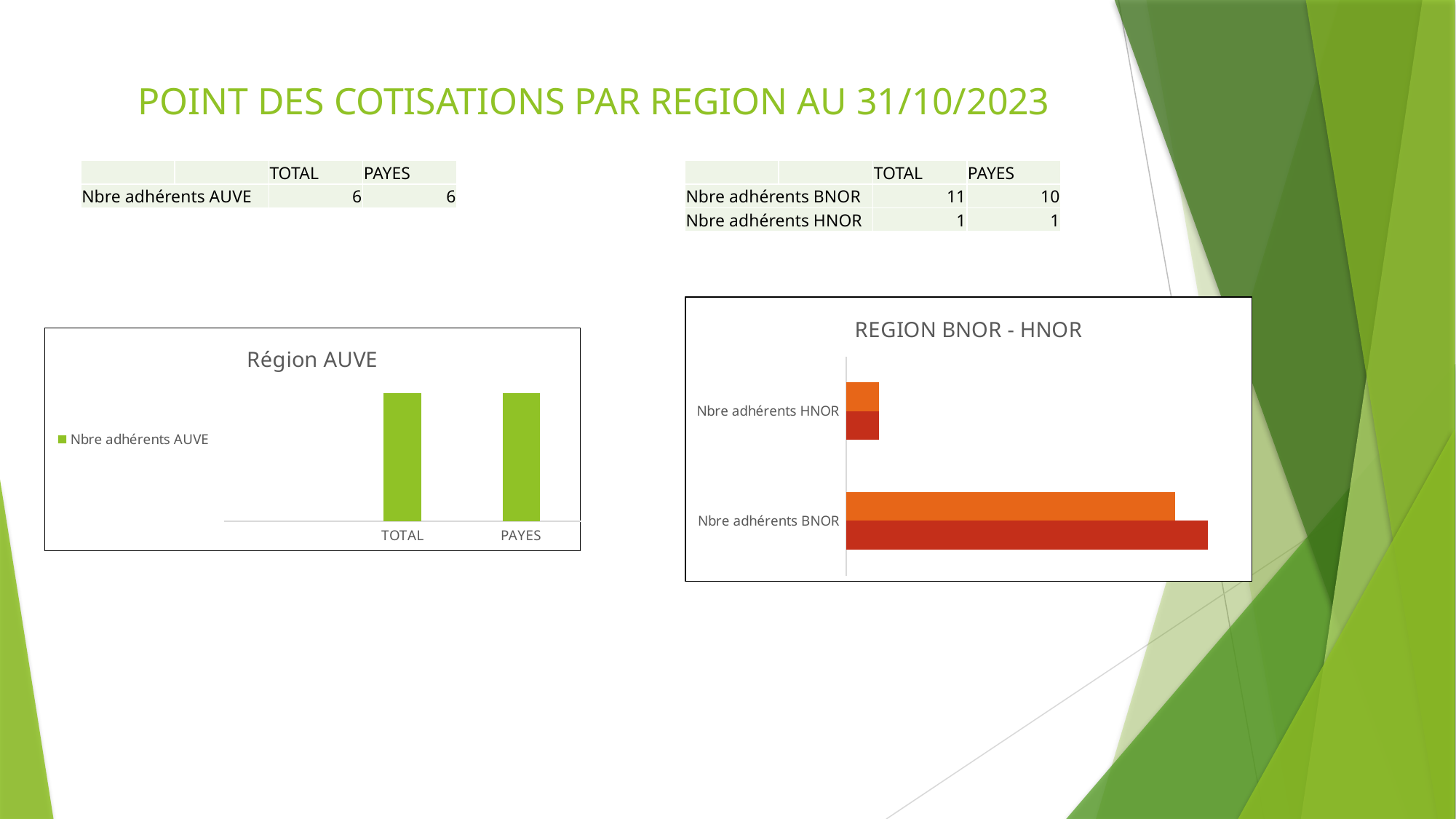
In the "Région AUVE" chart, how many categories are shown on the x axis? 2 In the "REGION BNOR - HNOR" chart, which category has the longest bars? Nbre adhérents BNOR What kind of chart is the "Région AUVE" chart? bar chart In the "REGION BNOR - HNOR" chart, how many categories are shown? 2 In the "REGION BNOR - HNOR" chart, which category has larger values, Nbre adhérents BNOR or Nbre adhérents HNOR? Nbre adhérents BNOR According to the table above the "REGION BNOR - HNOR" chart, what is the difference between TOTAL and PAYES for Nbre adhérents BNOR? 1 What is the title of the chart on the right side of the slide? REGION BNOR - HNOR According to the table above the "Région AUVE" chart, what is the TOTAL value for Nbre adhérents AUVE? 6 According to the table above the "REGION BNOR - HNOR" chart, what is the PAYES value for Nbre adhérents BNOR? 10 What kind of chart is the "REGION BNOR - HNOR" chart? bar chart In the "REGION BNOR - HNOR" chart, which category has the shortest bars? Nbre adhérents HNOR In the "Région AUVE" chart, how many series does the legend list? 1